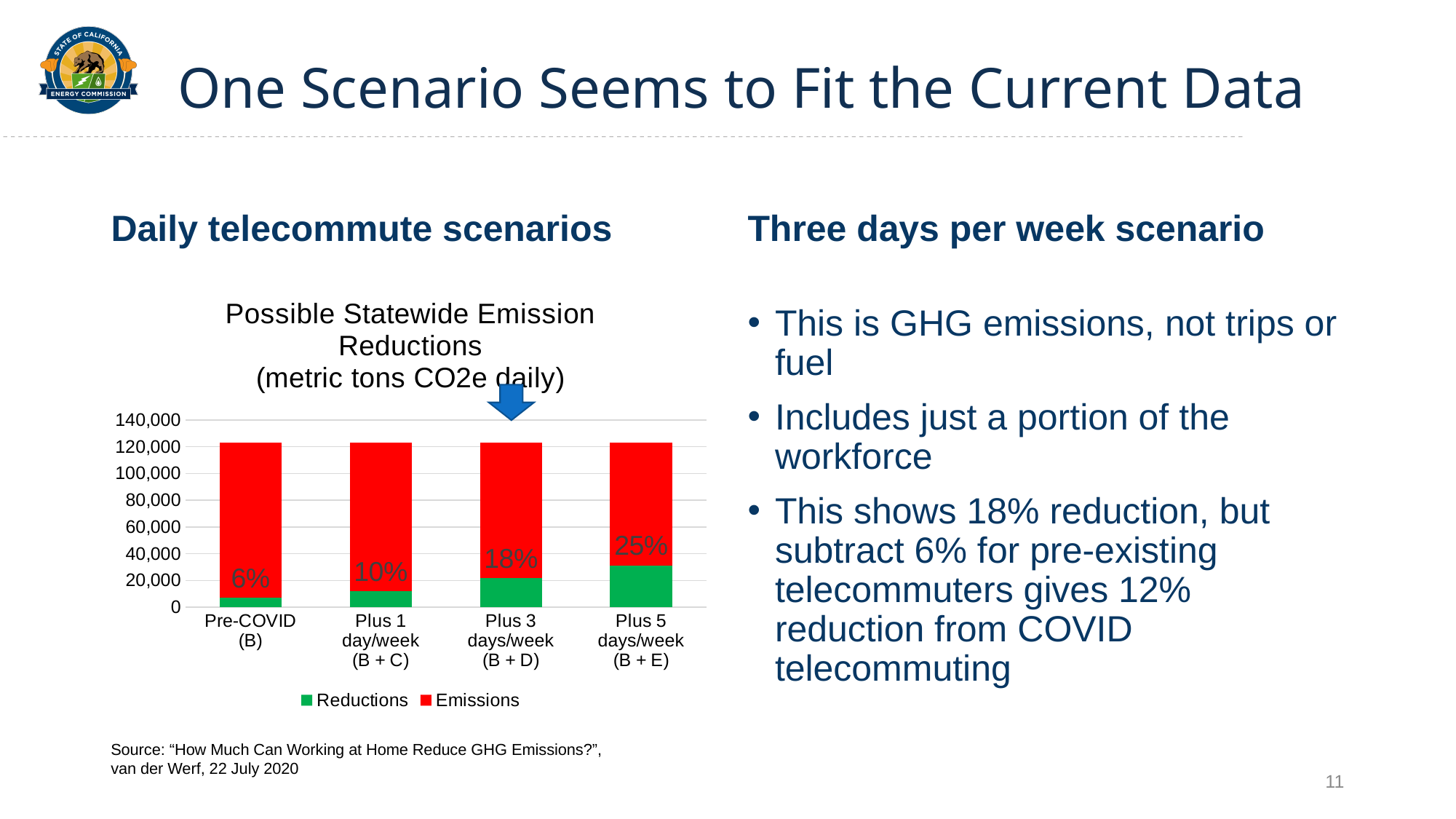
Which scenario has the lowest percentage label on its bar? Pre-COVID (B) Which has the larger Reductions segment, Plus 1 day/week (B + C) or Plus 3 days/week (B + D)? Plus 3 days/week (B + D) Is the Reductions value for Plus 5 days/week (B + E) greater or less than 40,000? less What percentage label is shown on the Pre-COVID (B) bar? 6% What kind of chart is shown on the slide? Stacked bar chart What percentage label is shown on the Plus 5 days/week (B + E) bar? 25% What is the difference between the percentage labels for Plus 5 days/week (B + E) and Pre-COVID (B)? 19% How many scenarios are shown on the x axis of the chart? 4 How many series does the chart legend list? 2 Which scenario has the highest percentage label on its bar? Plus 5 days/week (B + E) Is the total height of the Pre-COVID (B) bar greater or less than 100,000? greater What percentage label is shown on the Plus 3 days/week (B + D) bar? 18%